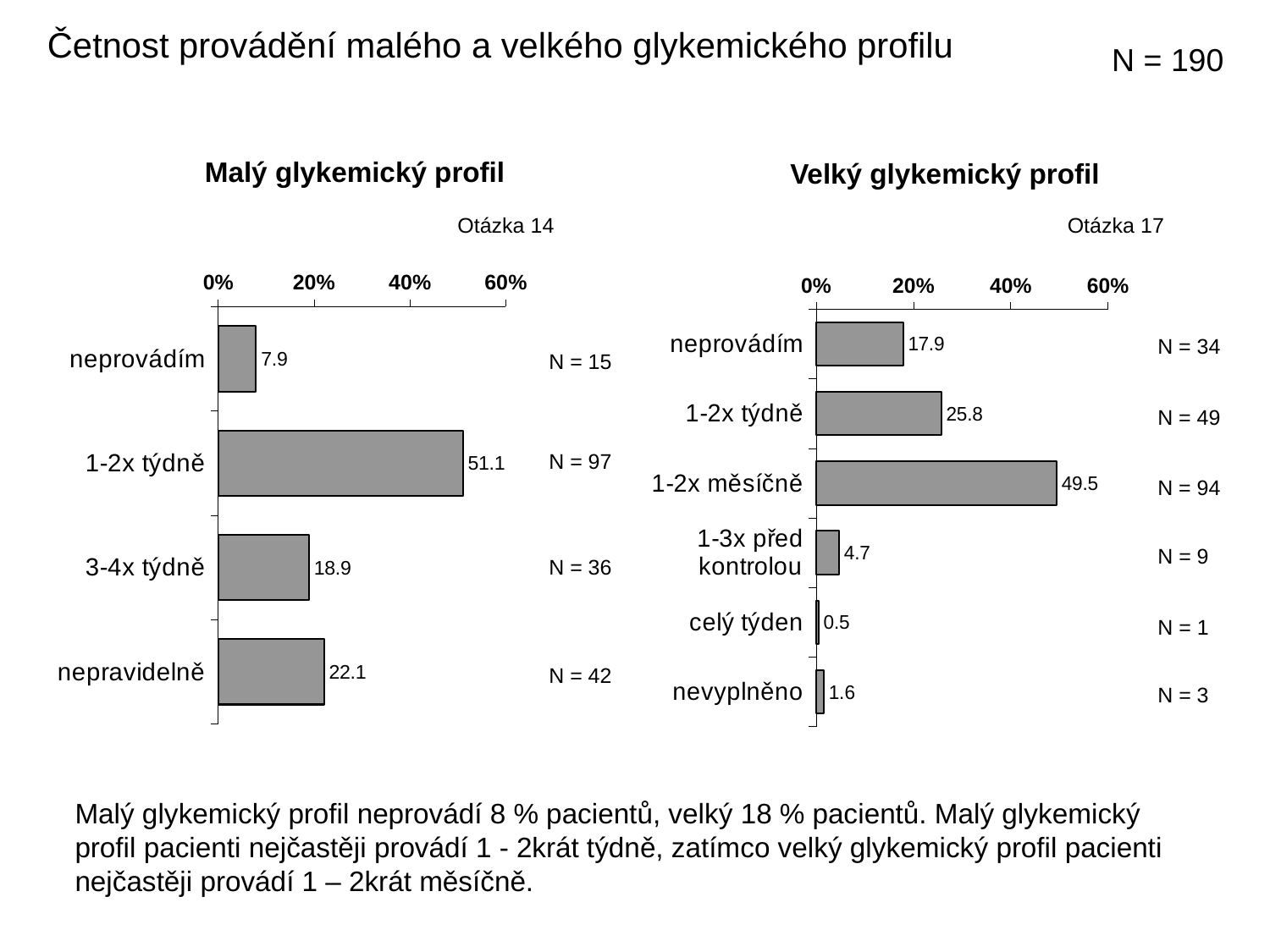
In the 'Velký glykemický profil' chart, what is the value for '1-2x měsíčně'? 49.5 In the 'Velký glykemický profil' chart, which category has the highest value? 1-2x měsíčně How many categories does the 'Velký glykemický profil' chart show? 6 What kind of chart is the 'Malý glykemický profil' chart? bar chart How many categories does the 'Malý glykemický profil' chart show? 4 In the 'Malý glykemický profil' chart, what is the difference between the values for 'nepravidelně' and '3-4x týdně'? 3.2 In the 'Malý glykemický profil' chart, is the value for '1-2x týdně' greater or less than 40%? greater In the 'Velký glykemický profil' chart, what is the value for 'nevyplněno'? 1.6 In the 'Velký glykemický profil' chart, which is larger: the value for 'neprovádím' or the value for '1-2x týdně'? 1-2x týdně In the 'Velký glykemický profil' chart, which category has the lowest value? celý týden In the 'Malý glykemický profil' chart, which category has the lowest value? neprovádím In the 'Malý glykemický profil' chart, what is the value for '1-2x týdně'? 51.1